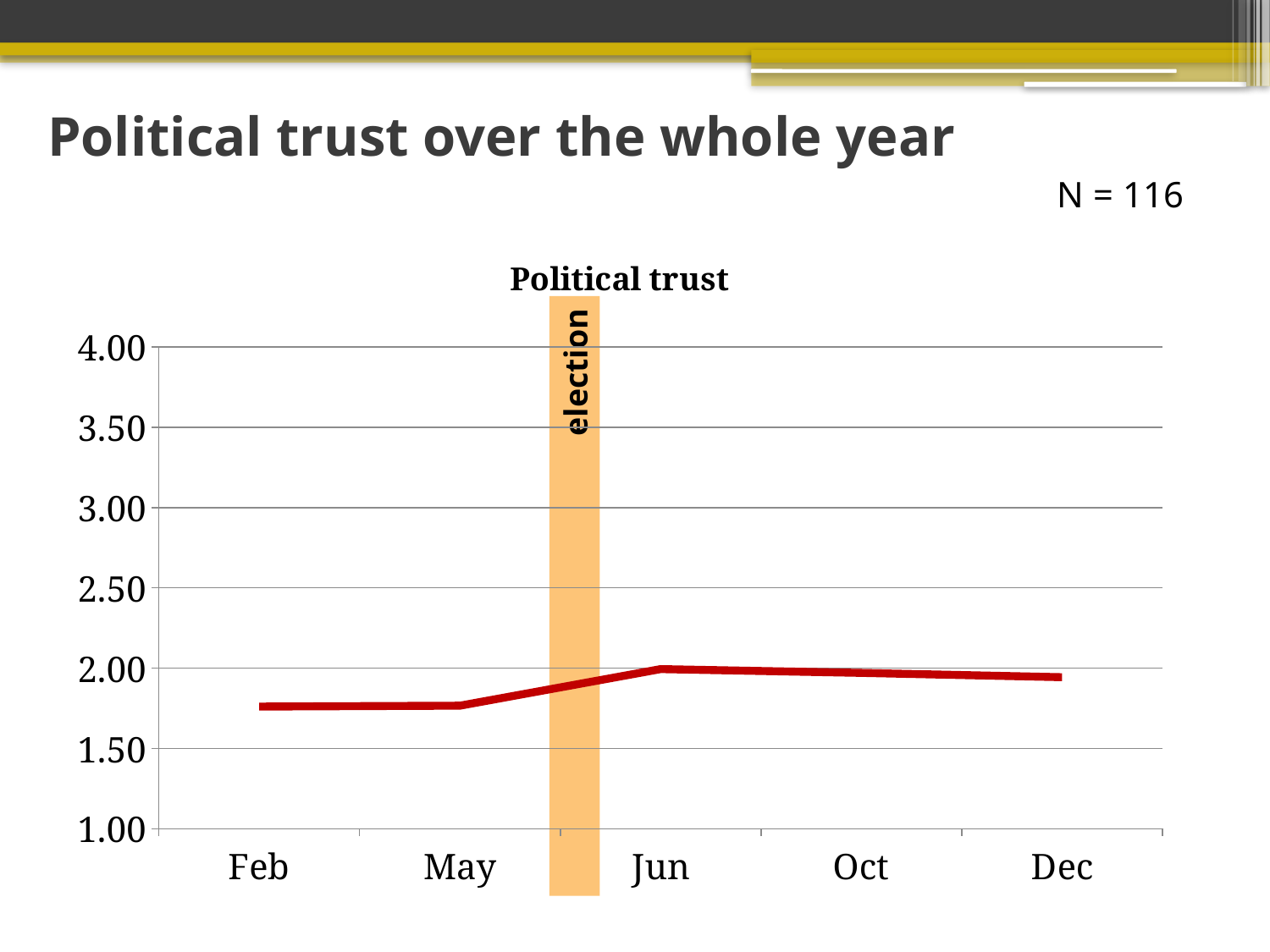
Is the value for Feb greater or less than 2.00? less Does political trust rise or fall between May and Jun? rise What kind of chart is shown on the slide? line chart Which is larger, the value for Jun or the value for Feb? Jun What is the highest value shown on the y axis of the chart? 4.00 What is the title of the chart? Political trust Is the value for May greater or less than 1.50? greater Between which two months on the x axis is the 'election' marker placed? May and Jun Is the value for Dec greater or less than 1.50? greater Which is larger, the value for May or the value for Dec? Dec How many months are plotted on the x axis of the chart? 5